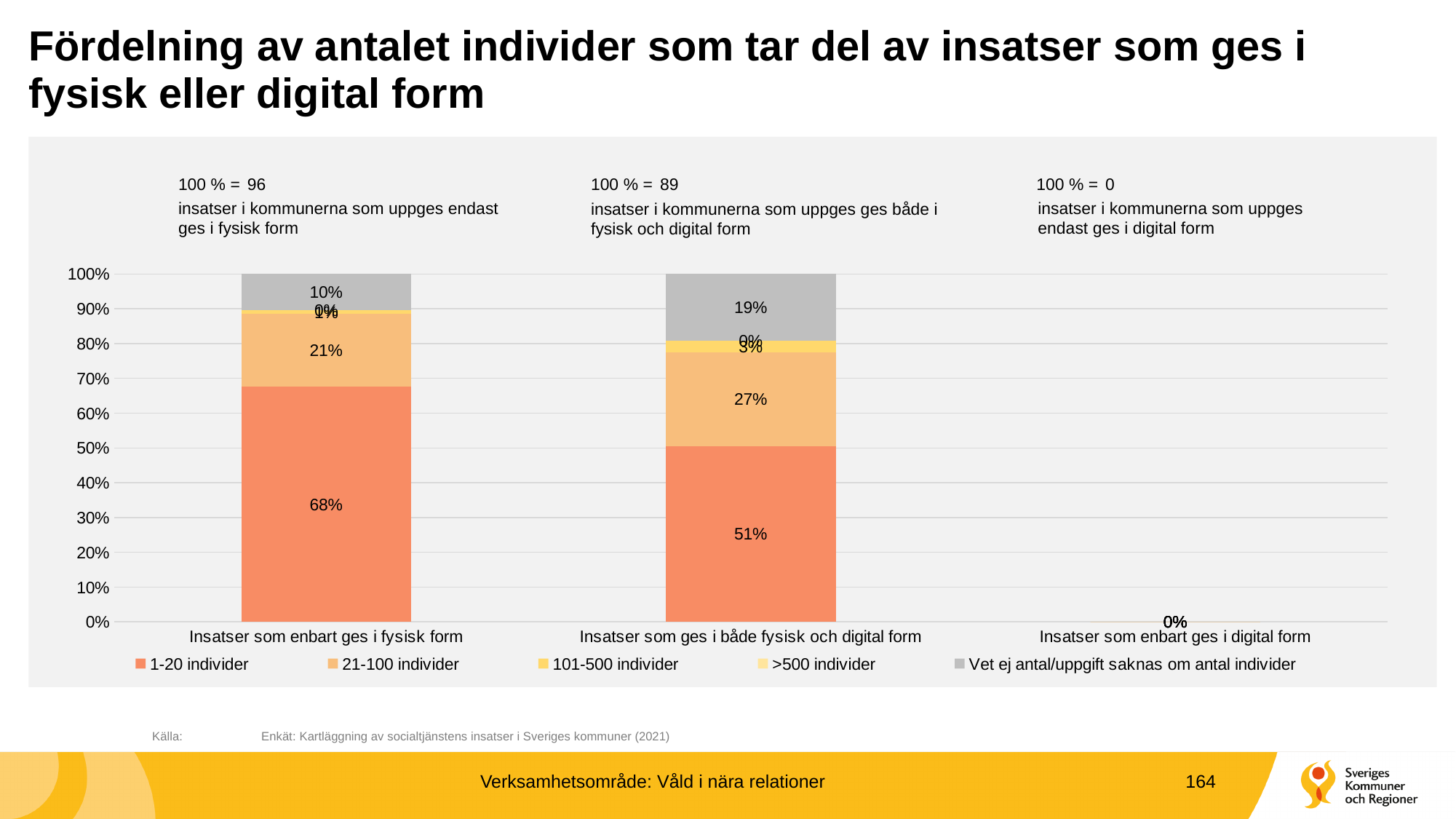
What is the value for "Vet ej antal/uppgift saknas om antal individer" in the "Insatser som ges i både fysisk och digital form" bar? 19% What is the value for "Vet ej antal/uppgift saknas om antal individer" in the "Insatser som enbart ges i fysisk form" bar? 10% What kind of chart is shown on the slide? Stacked bar chart How many categories are shown on the x axis of the chart? 3 How many series does the legend list? 5 What is the difference between the "1-20 individer" share for "Insatser som enbart ges i fysisk form" and for "Insatser som ges i både fysisk och digital form"? 17 percentage points What is the value for "21-100 individer" in the "Insatser som enbart ges i fysisk form" bar? 21% According to the text above the chart, how many insatser does 100 % correspond to for insatser som uppges endast ges i fysisk form? 96 What is the value for "1-20 individer" in the "Insatser som enbart ges i fysisk form" bar? 68% What is the value for "1-20 individer" in the "Insatser som ges i både fysisk och digital form" bar? 51% What is the value for "21-100 individer" in the "Insatser som ges i både fysisk och digital form" bar? 27% Which category has the larger "Vet ej antal/uppgift saknas om antal individer" share: "Insatser som enbart ges i fysisk form" or "Insatser som ges i både fysisk och digital form"? Insatser som ges i både fysisk och digital form